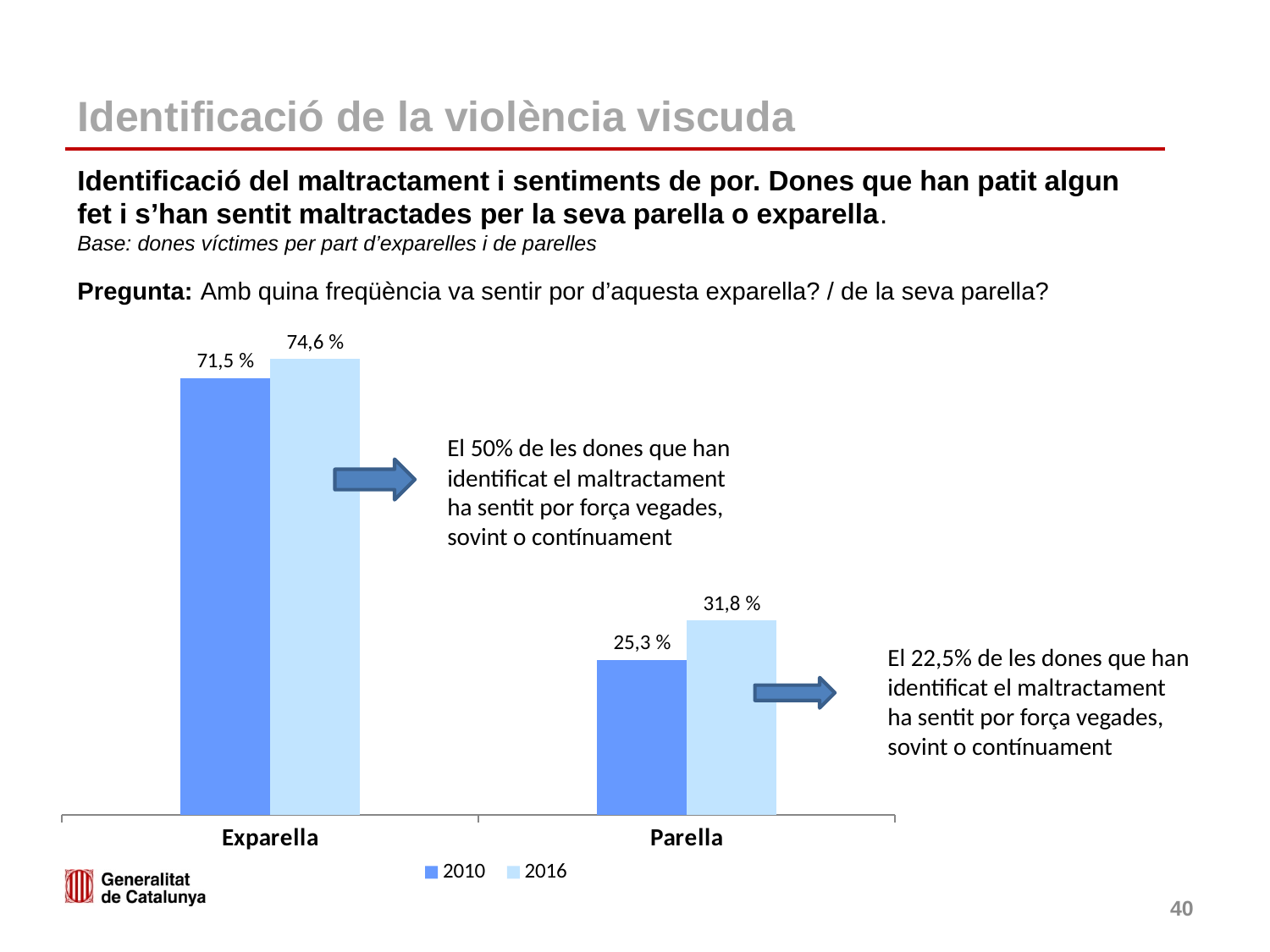
How many series does the legend list? 2 What is the difference between the 2016 and 2010 values for Exparella? 3,1 % Which category has the lowest value in 2010? Parella What is the value for Parella in 2010? 25,3 % What is the difference between the 2016 and 2010 values for Parella? 6,5 % How many categories are shown on the x axis? 2 Which category has the highest value in 2016? Exparella What kind of chart is shown on the slide? Bar chart What is the value for Exparella in 2016? 74,6 % Which is larger for Parella: the 2010 value or the 2016 value? 2016 What is the value for Parella in 2016? 31,8 % What is the value for Exparella in 2010? 71,5 %